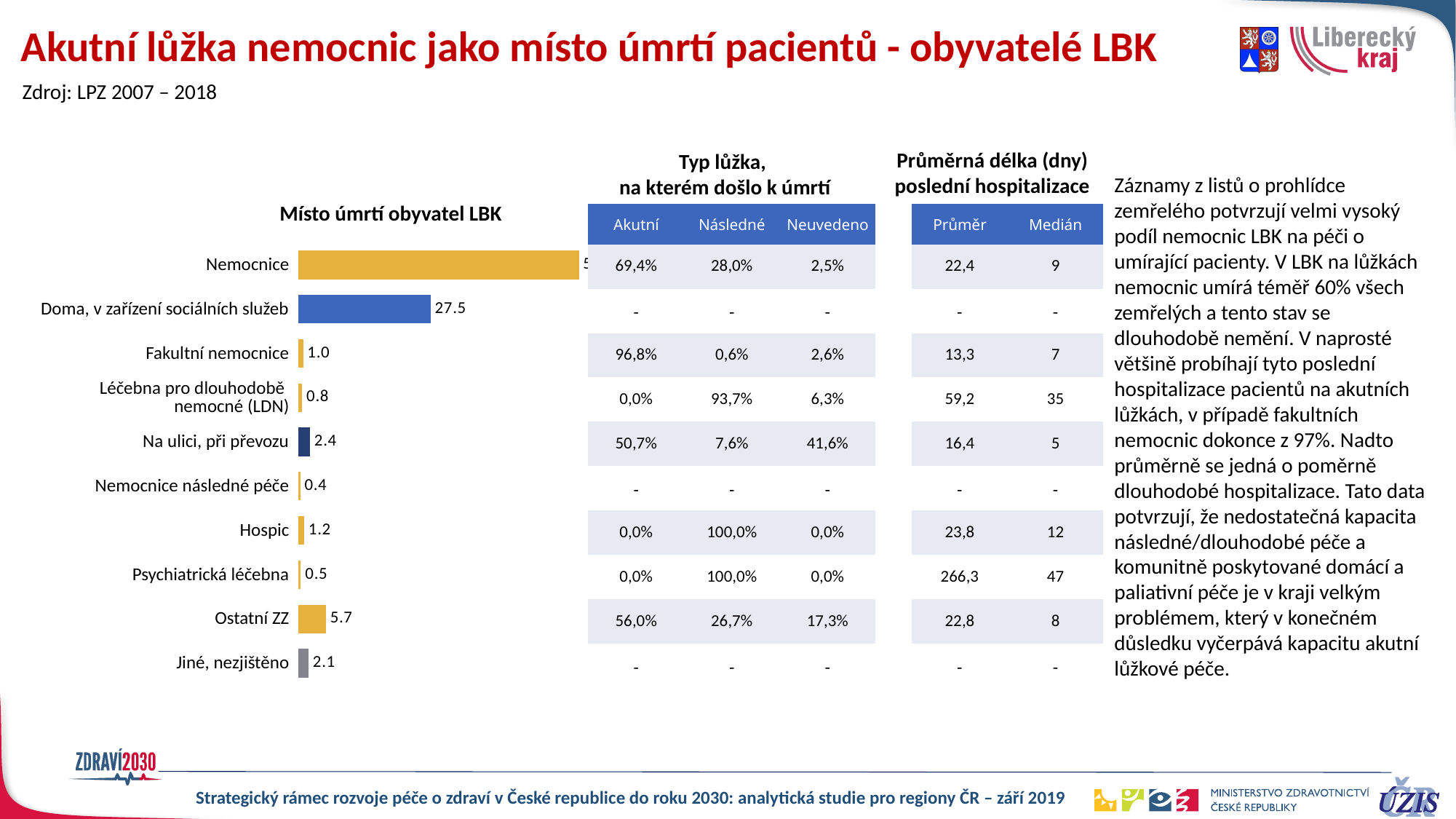
In the chart "Místo úmrtí obyvatel LBK", what is the value for "Na ulici, při převozu"? 2.4 In the chart "Místo úmrtí obyvatel LBK", what is the value for "Hospic"? 1.2 In the chart "Místo úmrtí obyvatel LBK", what is the difference between the values for "Doma, v zařízení sociálních služeb" and "Ostatní ZZ"? 21.8 In the chart "Místo úmrtí obyvatel LBK", how many categories are shown? 10 In the chart "Místo úmrtí obyvatel LBK", which is larger: the value for "Ostatní ZZ" or for "Jiné, nezjištěno"? Ostatní ZZ In the chart "Místo úmrtí obyvatel LBK", which category has the highest value? Nemocnice In the chart "Místo úmrtí obyvatel LBK", what is the value for "Léčebna pro dlouhodobě nemocné (LDN)"? 0.8 In the chart "Místo úmrtí obyvatel LBK", what is the value for "Ostatní ZZ"? 5.7 What kind of chart is "Místo úmrtí obyvatel LBK"? bar chart In the chart "Místo úmrtí obyvatel LBK", what is the value for "Doma, v zařízení sociálních služeb"? 27.5 In the chart "Místo úmrtí obyvatel LBK", what is the value for "Jiné, nezjištěno"? 2.1 In the chart "Místo úmrtí obyvatel LBK", what is the difference between the values for "Na ulici, při převozu" and "Hospic"? 1.2